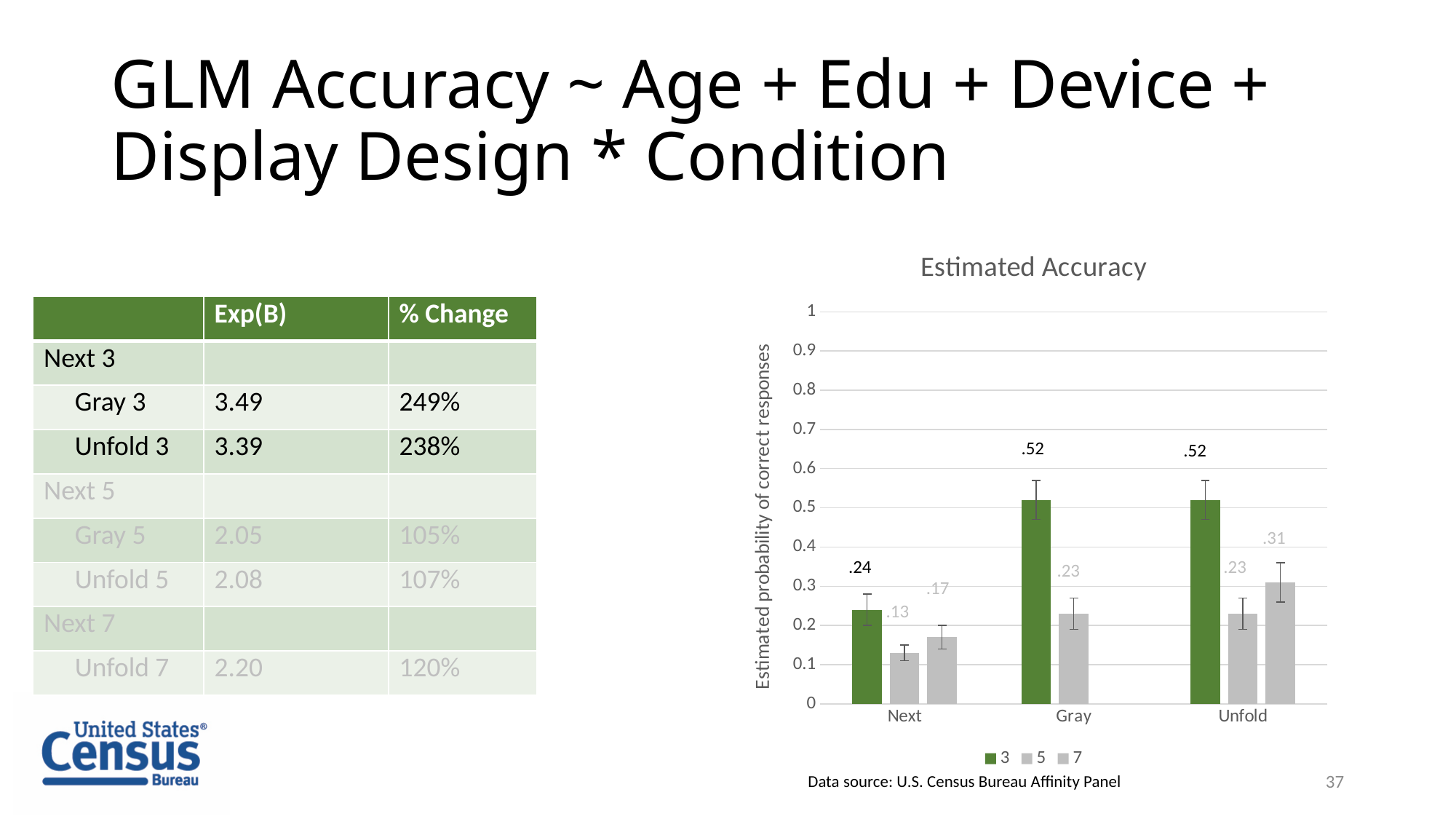
What is the value for series 3 in the Next category? .24 Which category has the lowest value for series 3? Next What is the y-axis label of the chart? Estimated probability of correct responses What type of chart is shown on the slide? bar chart What is the value for series 7 in the Unfold category? .31 How many categories are shown on the x axis of the chart? 3 Which is larger in the Next category: the value for series 5 or the value for series 7? series 7 What is the value for series 3 in the Gray category? .52 What is the title of the chart? Estimated Accuracy How many series does the chart legend list? 3 What is the difference between the series 3 value and the series 5 value in the Unfold category? .29 What is the value for series 5 in the Next category? .13